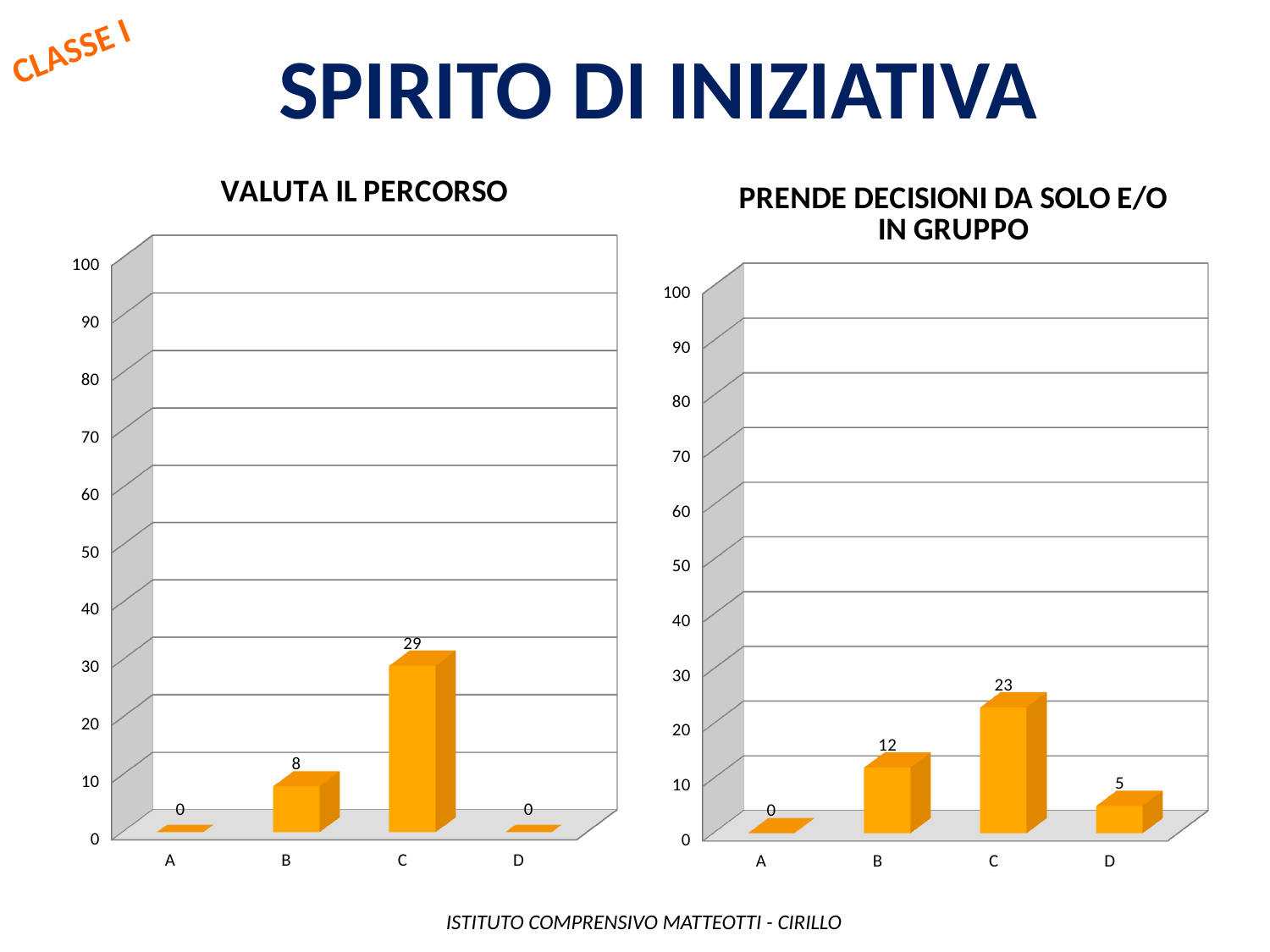
What is the title of the chart on the left side of the slide? VALUTA IL PERCORSO What kind of chart is the 'PRENDE DECISIONI DA SOLO E/O IN GRUPPO' chart? bar chart How many categories are shown on the x axis of the 'VALUTA IL PERCORSO' chart? 4 In the 'PRENDE DECISIONI DA SOLO E/O IN GRUPPO' chart, what is the difference between the values for C and D? 18 In the 'VALUTA IL PERCORSO' chart, what is the difference between the values for C and B? 21 In the 'PRENDE DECISIONI DA SOLO E/O IN GRUPPO' chart, what is the value for category B? 12 In the 'PRENDE DECISIONI DA SOLO E/O IN GRUPPO' chart, which category has the highest value? C In the 'VALUTA IL PERCORSO' chart, what is the value for category C? 29 In the 'VALUTA IL PERCORSO' chart, what is the value for category B? 8 In the 'VALUTA IL PERCORSO' chart, which category has the highest value? C In the 'PRENDE DECISIONI DA SOLO E/O IN GRUPPO' chart, what is the value for category D? 5 In the 'PRENDE DECISIONI DA SOLO E/O IN GRUPPO' chart, which is larger, the value for B or the value for D? B